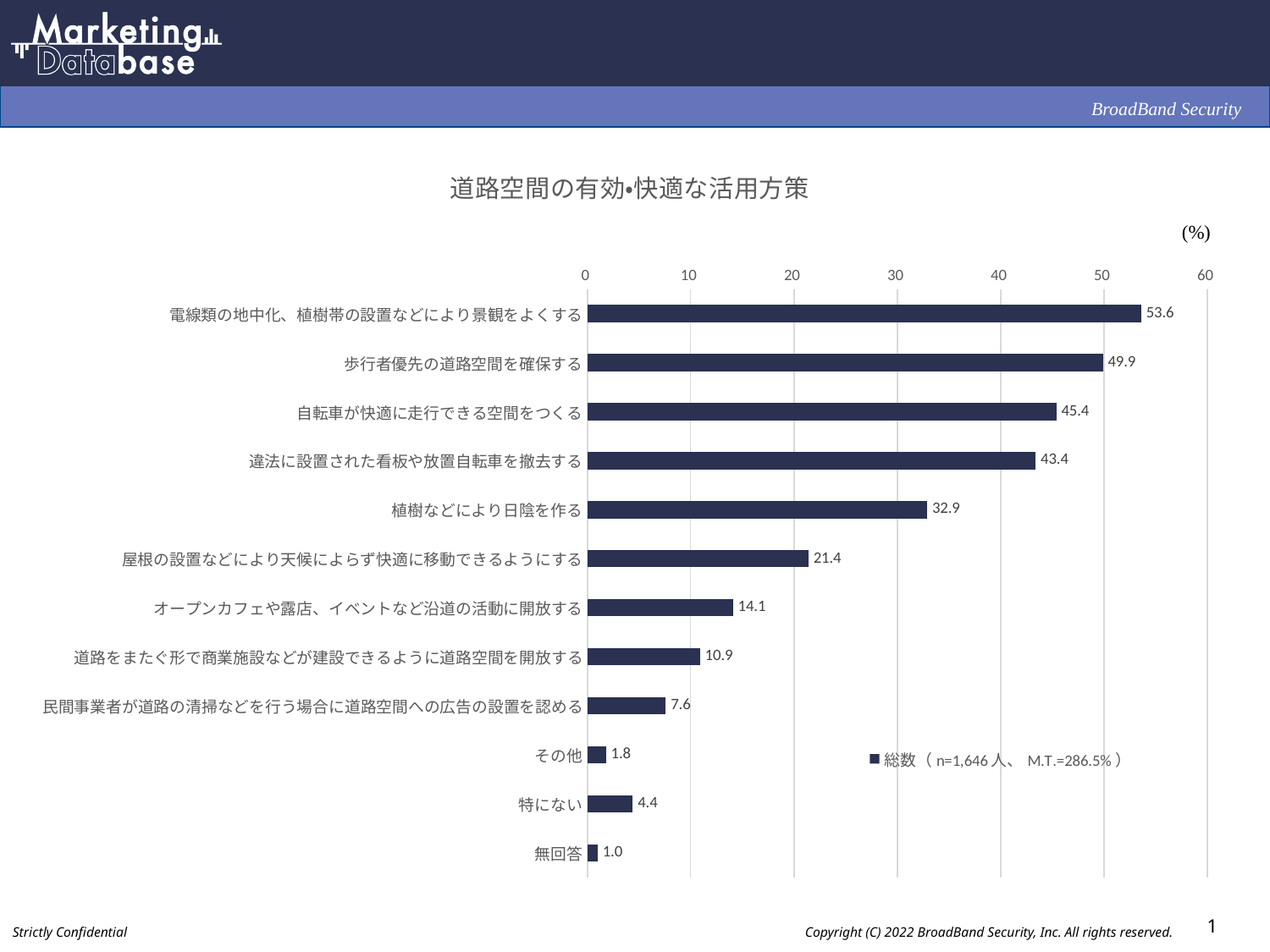
What is the value for 歩行者優先の道路空間を確保する? 49.9 Is the value for 屋根の設置などにより天候によらず快適に移動できるようにする greater or less than 20? greater Which category has the highest value? 電線類の地中化、植樹帯の設置などにより景観をよくする What kind of chart is shown on the slide? Bar chart What is the difference between the values for 自転車が快適に走行できる空間をつくる and 違法に設置された看板や放置自転車を撤去する? 2.0 Which category has the lowest value? 無回答 Which is larger: the value for オープンカフェや露店、イベントなど沿道の活動に開放する or the value for 道路をまたぐ形で商業施設などが建設できるように道路空間を開放する? オープンカフェや露店、イベントなど沿道の活動に開放する What is the title of the chart? 道路空間の有効•快適な活用方策 How many categories are shown in the chart? 12 How many series does the legend list? 1 What is the value for 特にない? 4.4 What is the value for 植樹などにより日陰を作る? 32.9